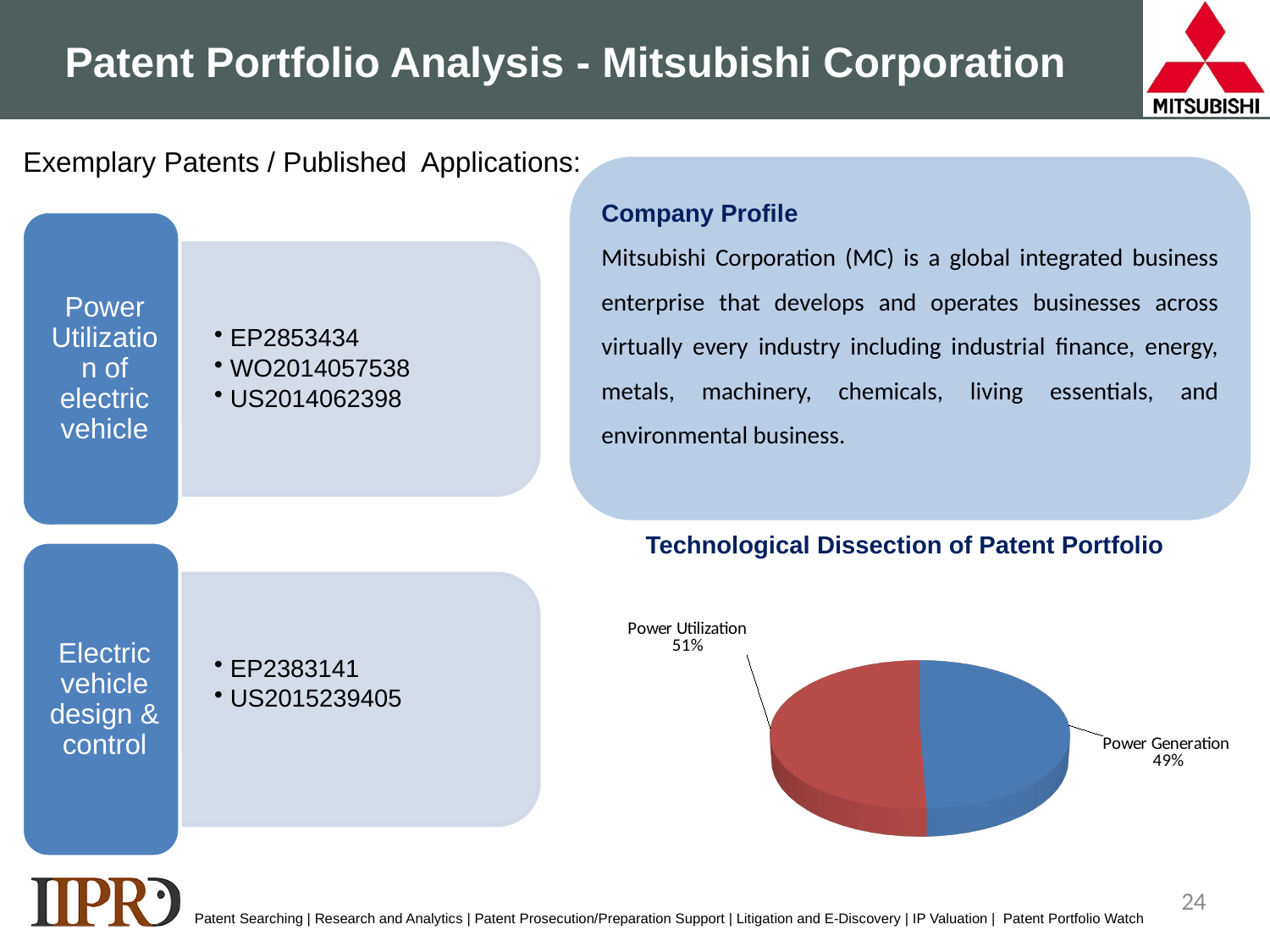
What type of chart is shown under 'Technological Dissection of Patent Portfolio'? Pie chart What is the title of the pie chart? Technological Dissection of Patent Portfolio What colour is the Power Generation slice in the pie chart? Blue What share of the pie chart does Power Utilization represent? 51% Which slice of the pie chart is the largest? Power Utilization Which is larger in the pie chart, Power Utilization or Power Generation? Power Utilization How many slices does the pie chart have? 2 What is the difference in percentage points between the Power Utilization and Power Generation slices? 2% Which slice of the pie chart is the smallest? Power Generation What share of the pie chart does Power Generation represent? 49%